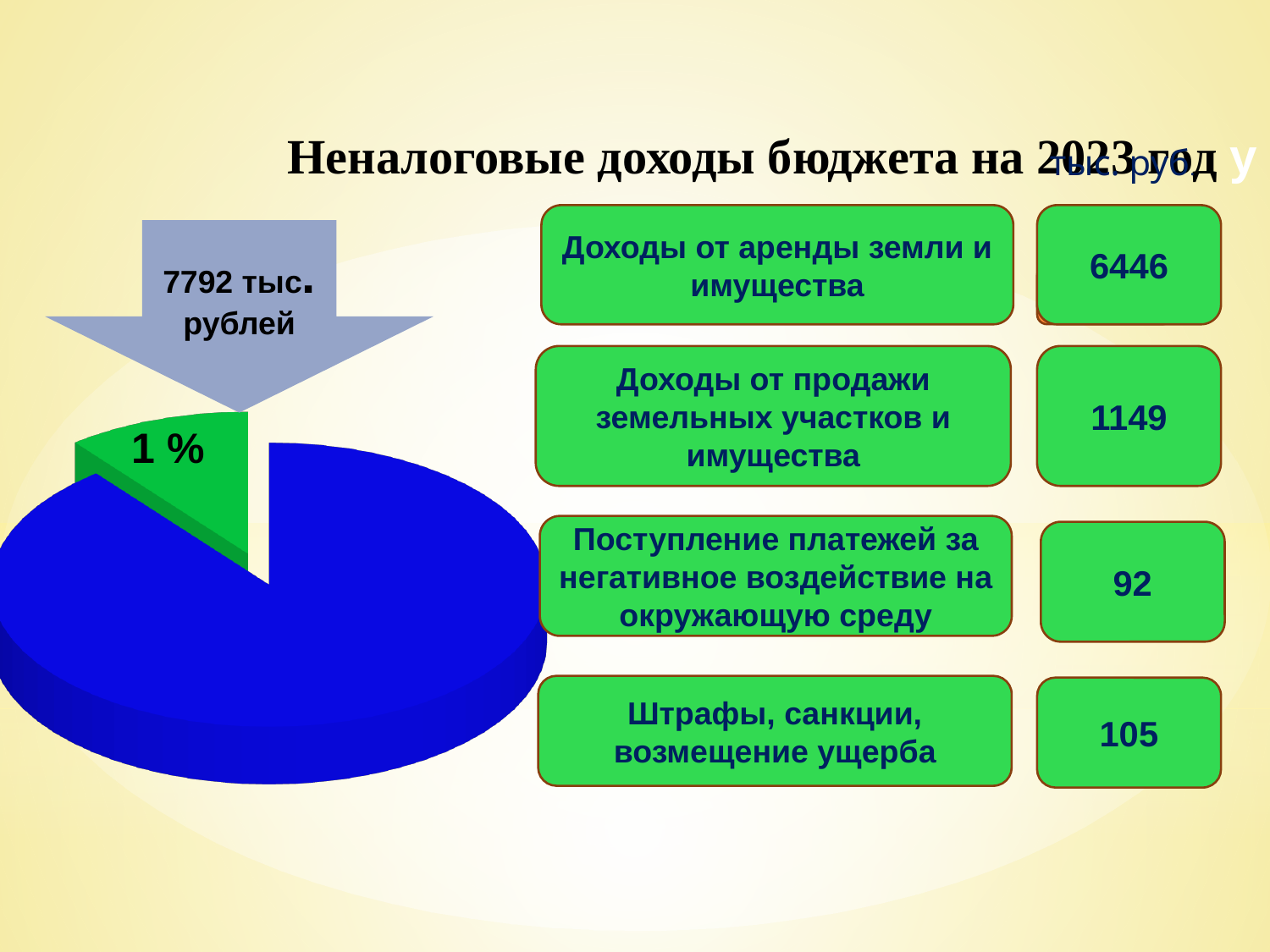
What total amount is printed in the arrow pointing at the pie chart? 7792 тыс. рублей What colour is the slice labelled 1 % in the pie chart? green Which slice of the pie chart is the smallest? the green slice Which slice of the pie chart is larger, the blue one or the green one? the blue one How many slices does the pie chart have? 2 What share of the pie does the small green slice represent? 1 % What is the title of the slide containing the pie chart? Неналоговые доходы бюджета на 2023 год What kind of chart is shown on the slide? pie chart Which slice of the pie chart is the largest? the blue slice